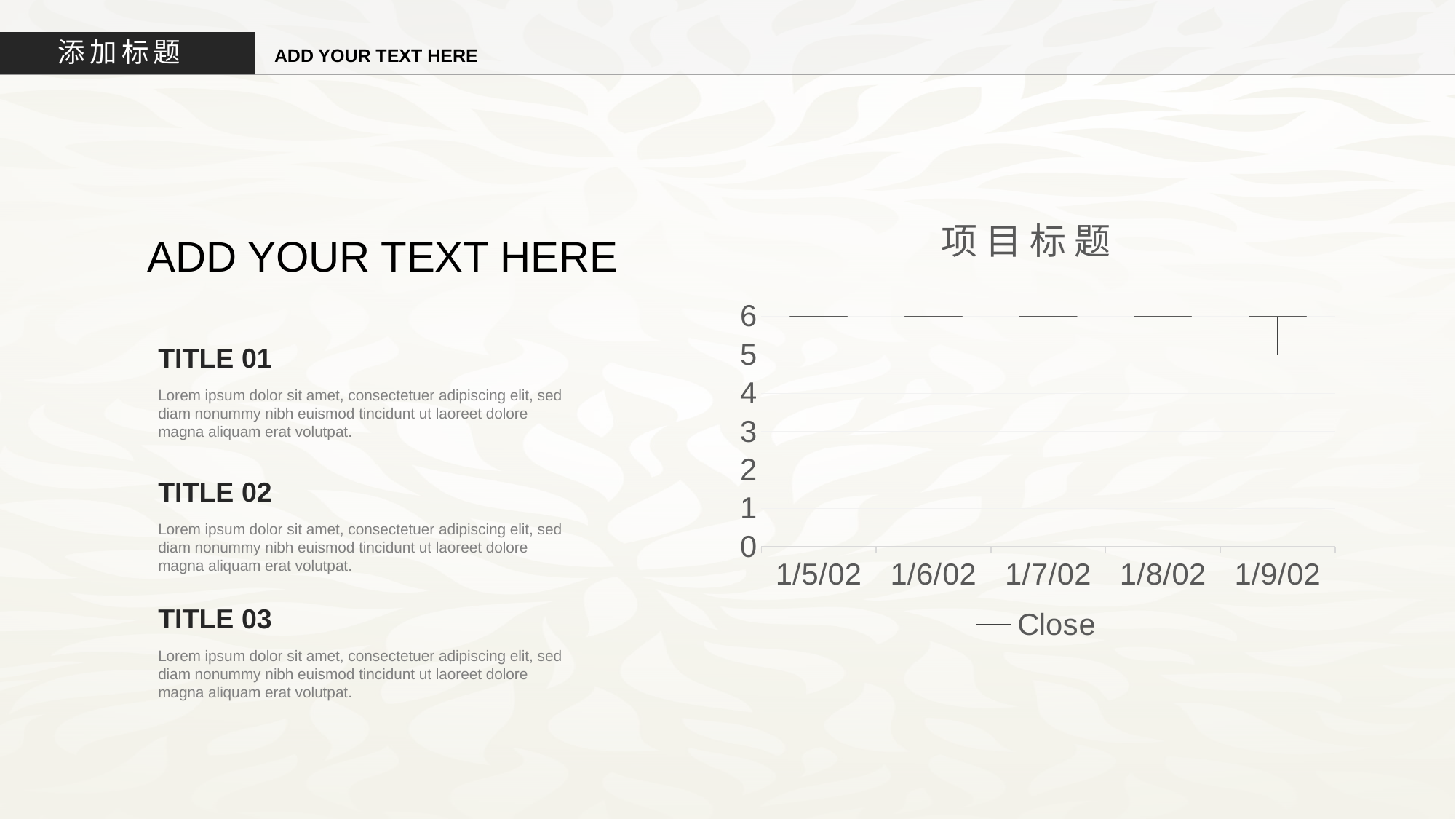
What is the name of the series shown in the chart legend? Close What is the title of the chart? 项目标题 What is the last date shown on the x axis of the chart? 1/9/02 What is the highest value shown on the y axis of the chart? 6 Is the Close value for 1/8/02 greater or less than 4? greater What is the first date shown on the x axis of the chart? 1/5/02 How many dates are shown on the x axis of the chart? 5 How many series does the chart legend list? 1 Is the Close value for 1/6/02 greater or less than 3? greater